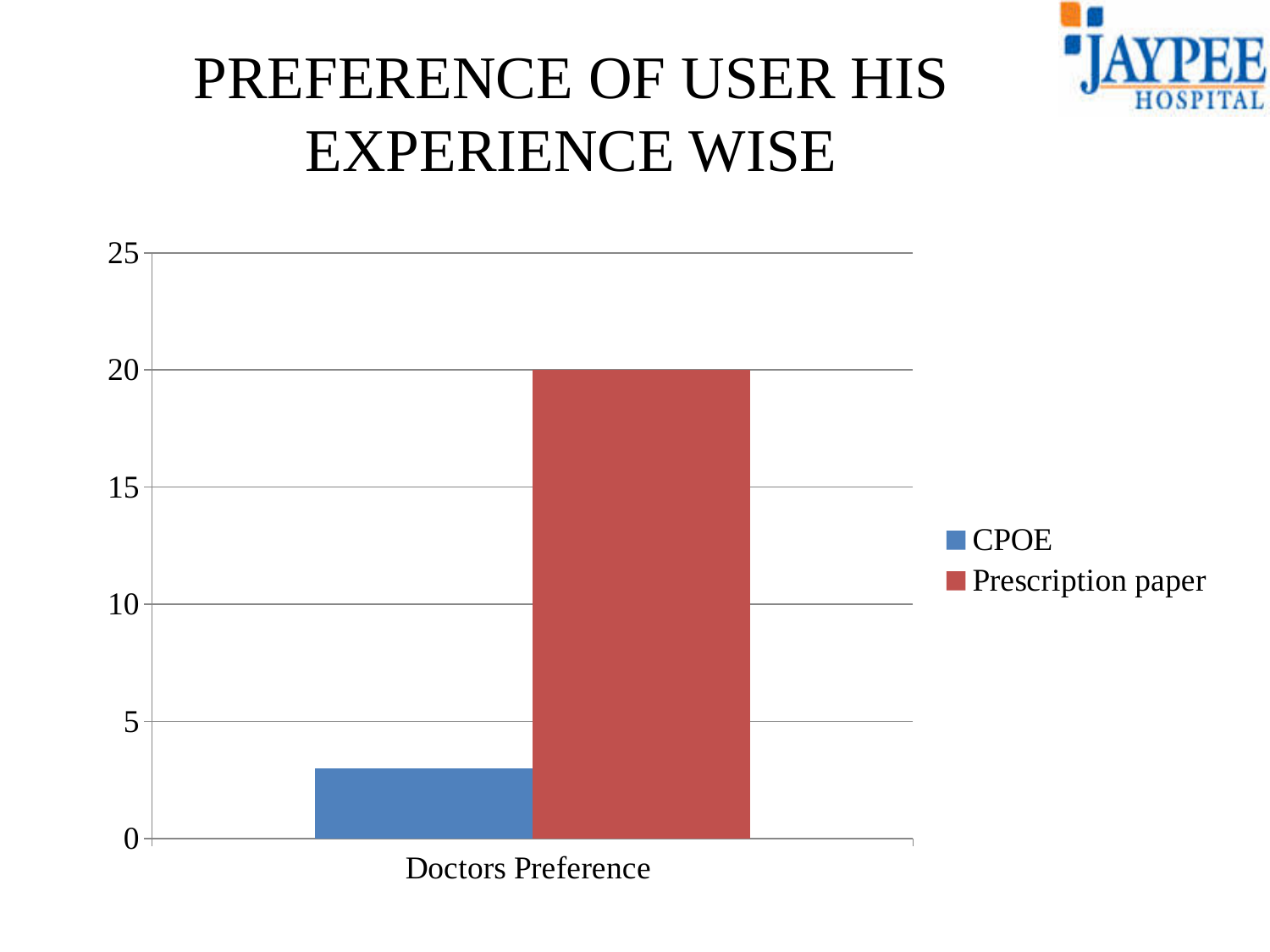
What type of chart is shown on the slide? bar chart Which series has the lowest value in the chart? CPOE How many series does the legend list? 2 What is the maximum value shown on the y axis? 25 Is the value for CPOE greater or less than 5? less Which series has the higher value for Doctors Preference, CPOE or Prescription paper? Prescription paper How many categories are shown on the x axis? 1 Is the value for Prescription paper greater or less than 15? greater What are the two series listed in the legend? CPOE and Prescription paper What is the category label on the x axis? Doctors Preference What is the value for Prescription paper under Doctors Preference? 20 Which series has the highest value in the chart? Prescription paper